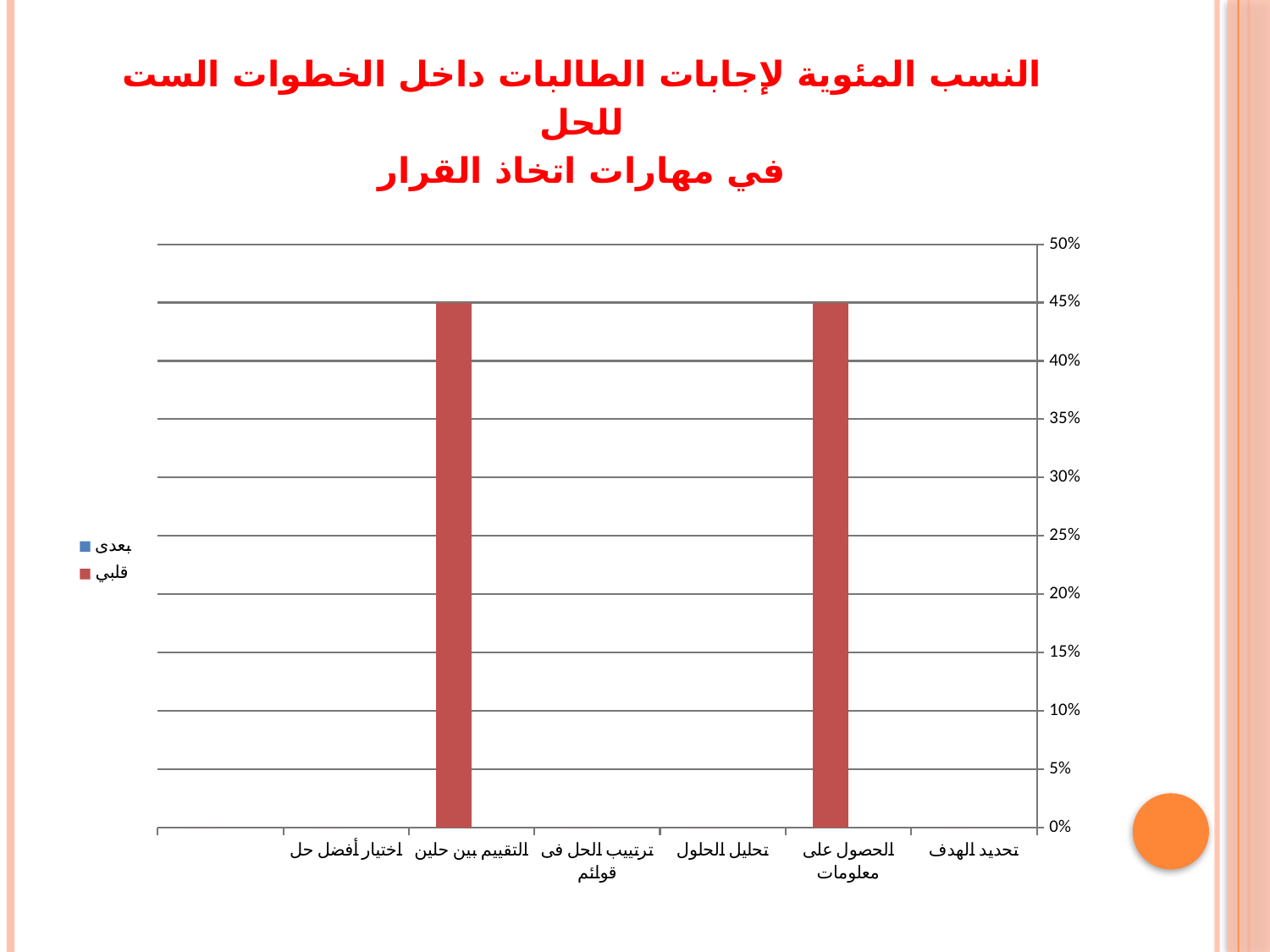
What is the value of the قبلي bar for الحصول على معلومات? 45% What are the two entries in the legend? بعدى and قلبي What is the value of the قبلي bar for التقييم بين حلين? 45% Is the value for الحصول على معلومات greater or less than 40%? greater What colour represents the قبلي series? red What kind of chart is shown on the slide? bar chart What is the difference between the قبلي values for الحصول على معلومات and التقييم بين حلين? 0% Is the value for التقييم بين حلين greater or less than 50%? less What is the highest value shown on the vertical axis? 50% How many categories are shown on the x axis? 6 Which is larger, the bar for الحصول على معلومات or the bar for تحليل الحلول? الحصول على معلومات How many series does the legend list? 2